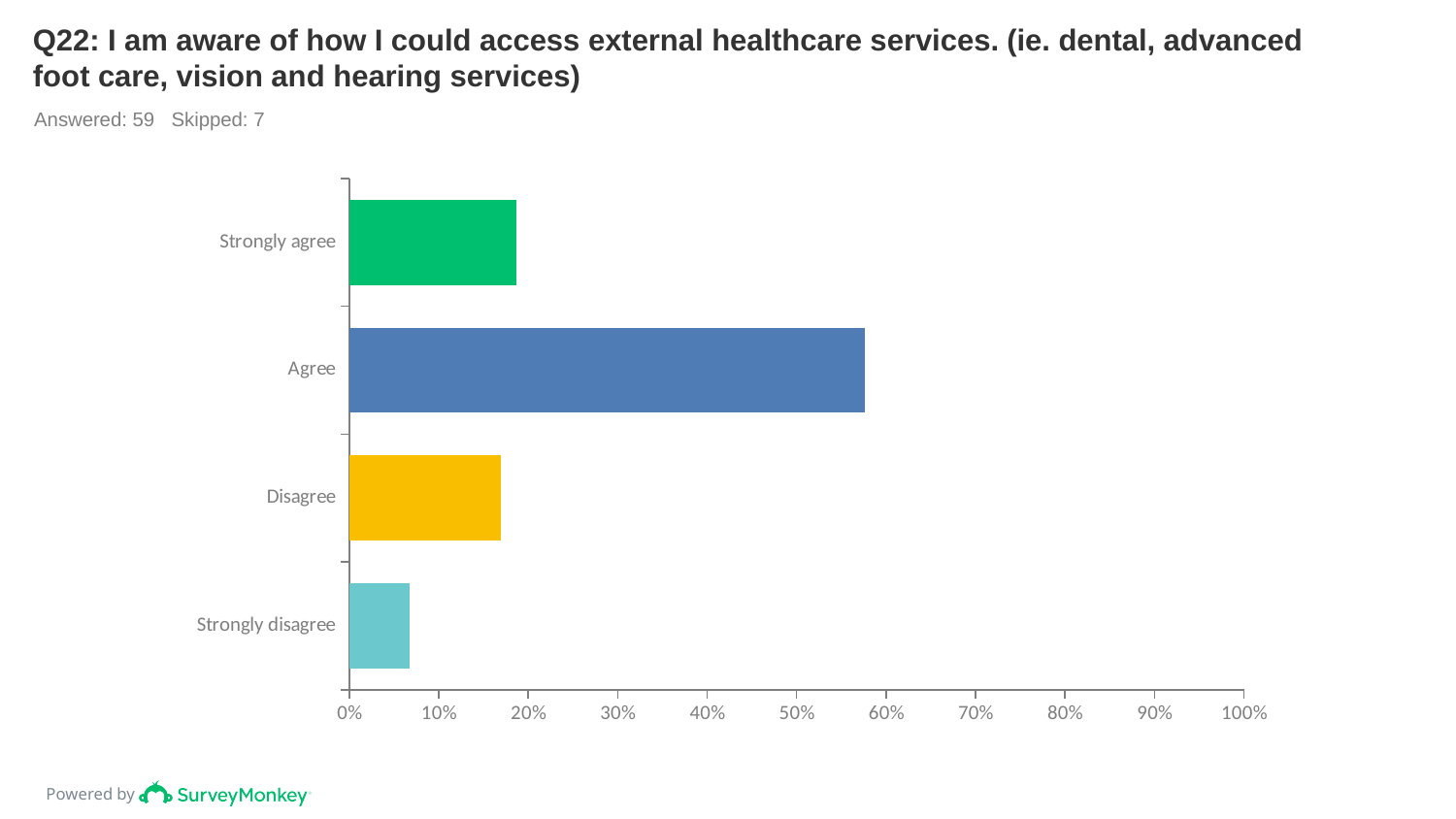
How many response categories are shown in the chart? 4 Is the value for Agree greater or less than 50%? greater Is the value for Disagree greater or less than 20%? less What kind of chart is shown on the slide? Bar chart Is the value for Strongly agree greater or less than 10%? greater Which response category has the highest value? Agree How many respondents answered this question according to the slide? 59 Which response category has the lowest value? Strongly disagree Which is larger, the value for Disagree or the value for Strongly disagree? Disagree Which is larger, the value for Agree or the value for Strongly agree? Agree